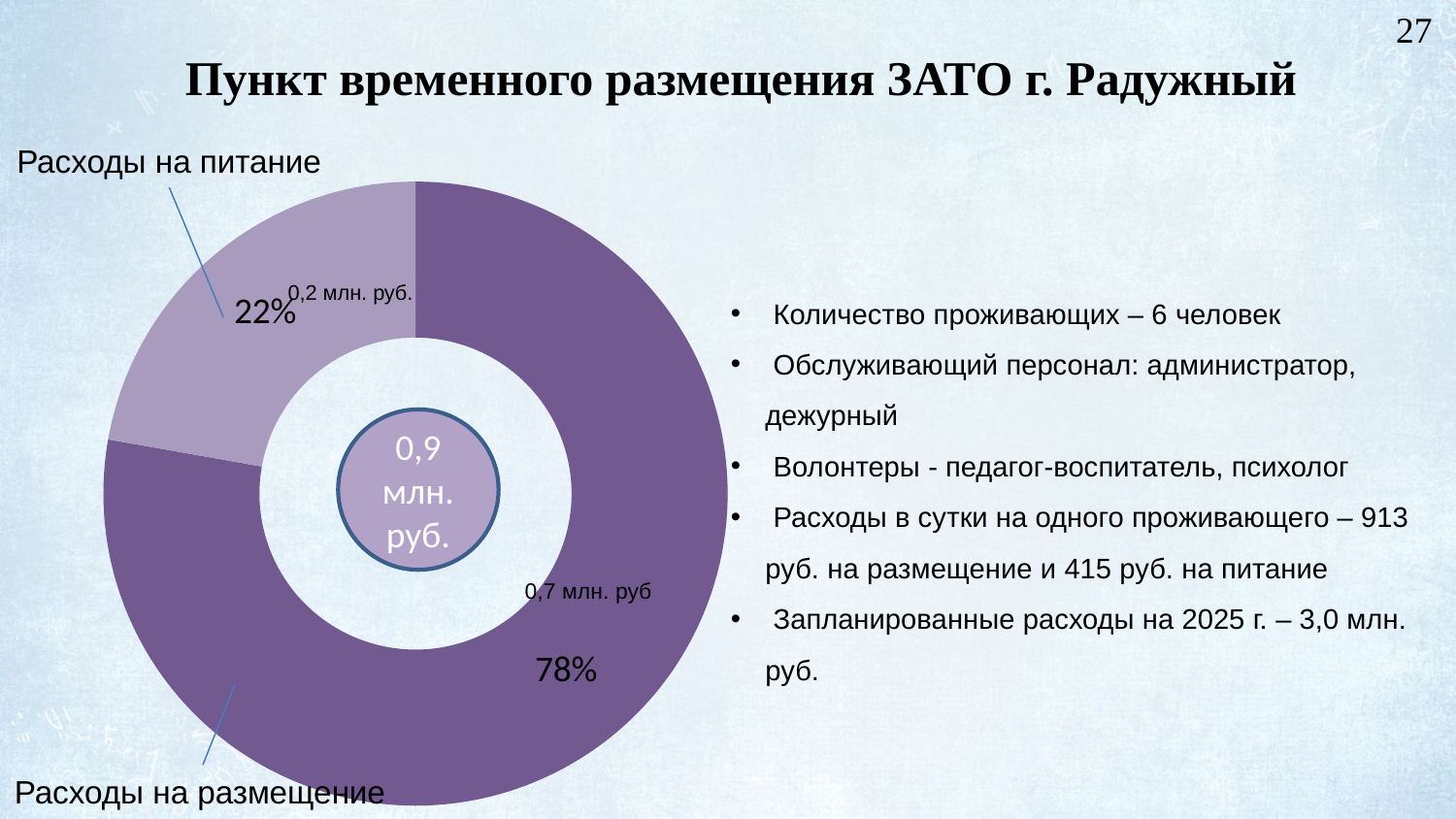
What is the title of the slide containing the chart? Пункт временного размещения ЗАТО г. Радужный What value in million rubles is shown for "Расходы на питание"? 0,2 млн. руб. Which is larger, the share for "Расходы на размещение" or for "Расходы на питание"? Расходы на размещение Which category has the smallest share of the chart? Расходы на питание How many slices does the chart have? 2 What value in million rubles is shown for "Расходы на размещение"? 0,7 млн. руб What is the difference in percentage points between the shares of "Расходы на размещение" and "Расходы на питание"? 56 Which category has the largest share of the chart? Расходы на размещение What total value is shown in the centre of the doughnut chart? 0,9 млн. руб. What kind of chart is shown on the slide? Doughnut chart What percentage share does "Расходы на размещение" have in the chart? 78% What percentage share does "Расходы на питание" have in the chart? 22%